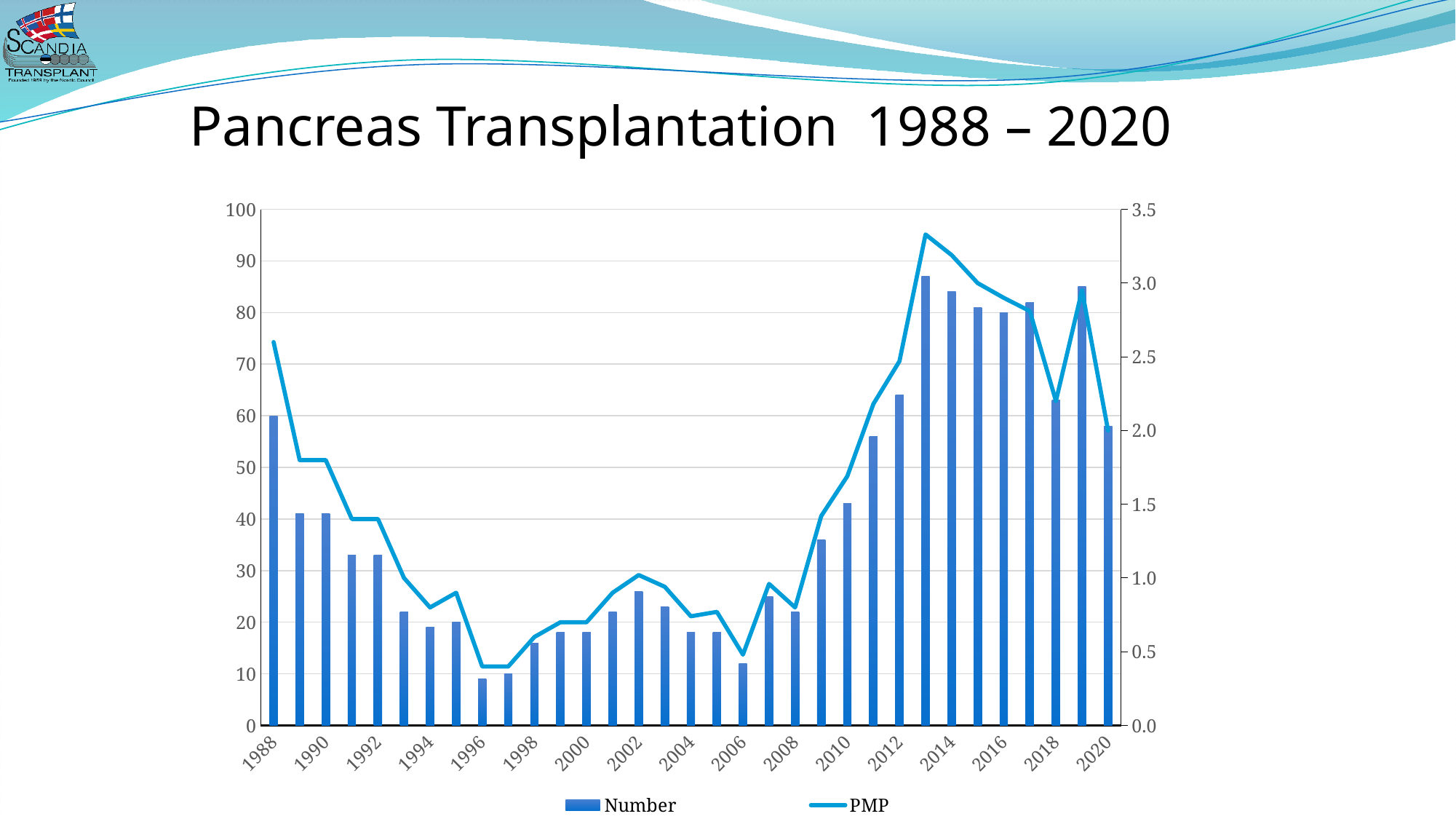
What are the two series named in the legend? Number and PMP Which year has the larger Number value, 1988 or 1990? 1988 How many years (bars) are plotted on the x axis? 33 Is the Number value for 2006 greater or less than 20? less What kind of chart is shown on the slide? A bar chart combined with a line What is the Number value for 1988? 60 What is the title of the slide's chart? Pancreas Transplantation 1988 – 2020 How many series does the legend list? 2 Is the PMP value for 2013 greater or less than 3.0? greater Is the Number value for 2013 greater or less than 80? greater In which year does the PMP line reach its highest point? 2013 Do the Number bars rise or fall from 2006 to 2013? rise